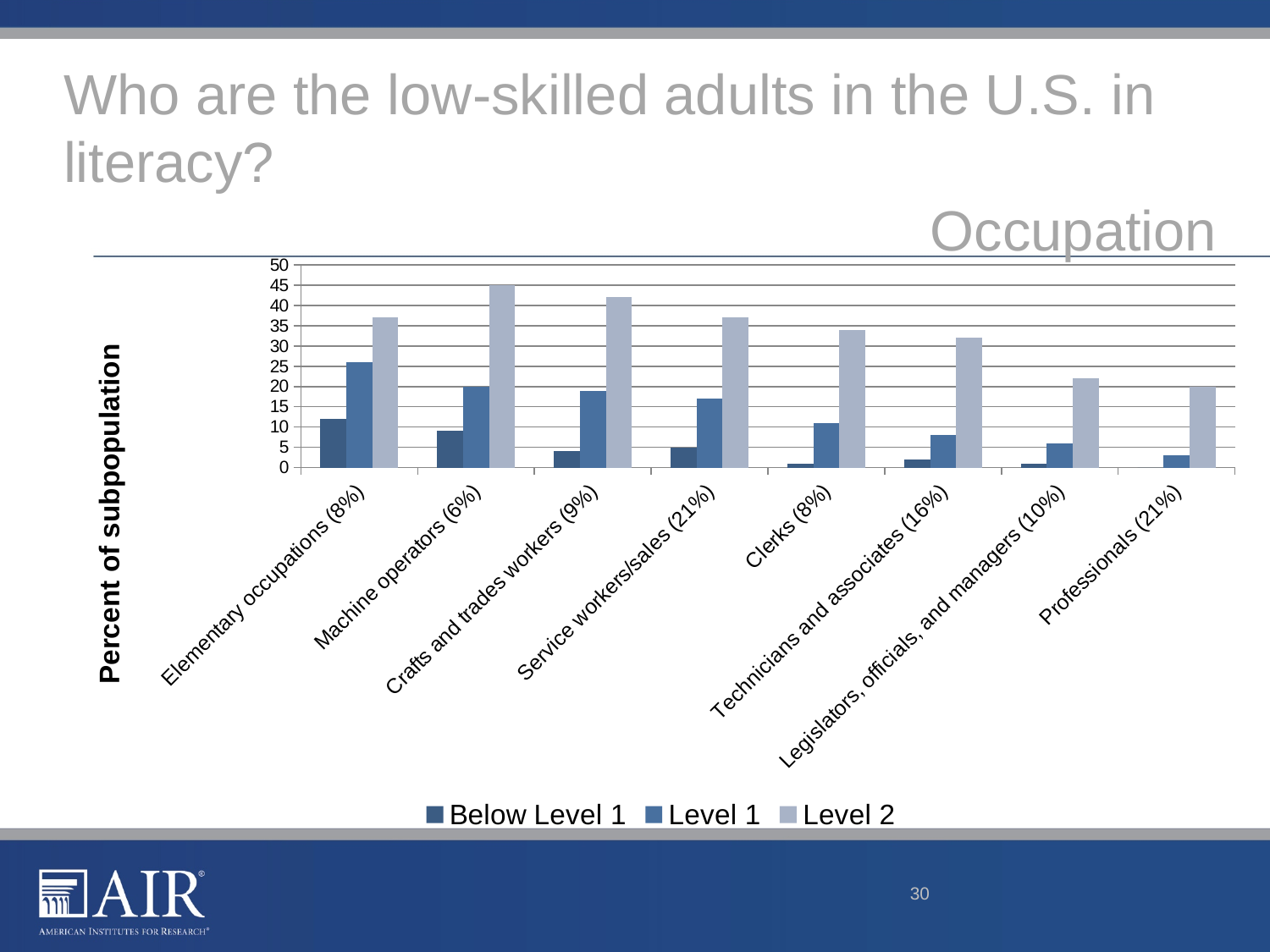
Is the Level 1 value for Technicians and associates (16%) greater or less than 10? less Which is larger, the Level 2 value for Clerks (8%) or for Professionals (21%)? Clerks (8%) Which is larger, the Level 1 value for Elementary occupations (8%) or for Machine operators (6%)? Elementary occupations (8%) Which occupation has the highest Below Level 1 value? Elementary occupations (8%) How many occupation categories are shown on the x axis? 8 Is the Level 2 value for Crafts and trades workers (9%) greater or less than 40? greater Which occupation has the highest Level 2 value? Machine operators (6%) Is the Below Level 1 value for Elementary occupations (8%) greater or less than 10? greater What is the title of the y axis? Percent of subpopulation Which occupation has the lowest Level 2 value? Professionals (21%) What kind of chart is shown on the slide? Bar chart How many series does the legend list? 3